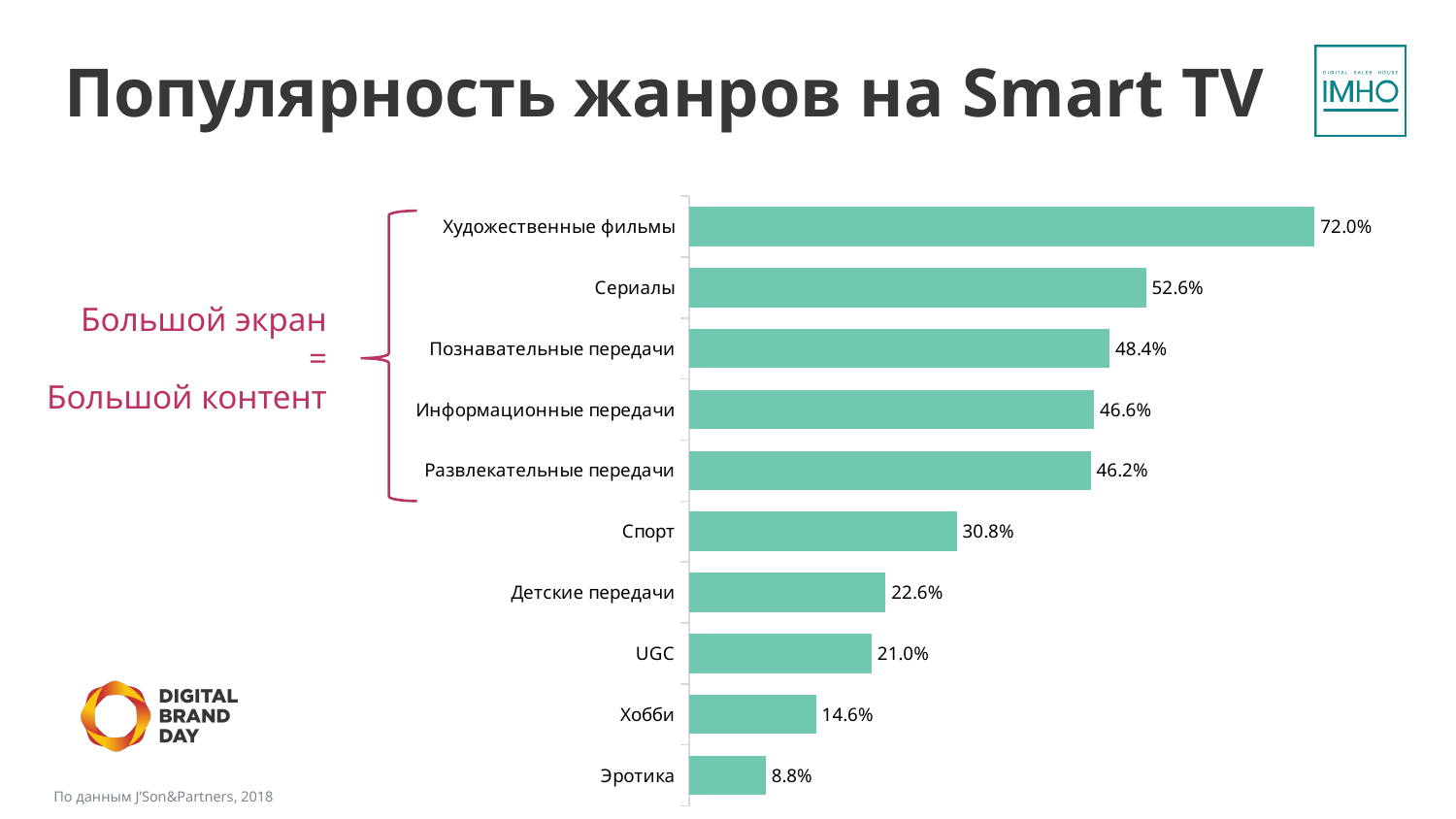
Which category has the lowest value? Эротика What is the difference between the values for Детские передачи and Хобби? 8.0% What is the value for Эротика? 8.8% What is the title of the slide? Популярность жанров на Smart TV Which is larger, the value for Познавательные передачи or the value for Спорт? Познавательные передачи What kind of chart is shown on the slide? bar chart What is the value for Спорт? 30.8% How many categories are shown in the chart? 10 What is the value for Художественные фильмы? 72.0% Which category has the highest value? Художественные фильмы What is the value for UGC? 21.0% What is the difference between the values for Художественные фильмы and Сериалы? 19.4%